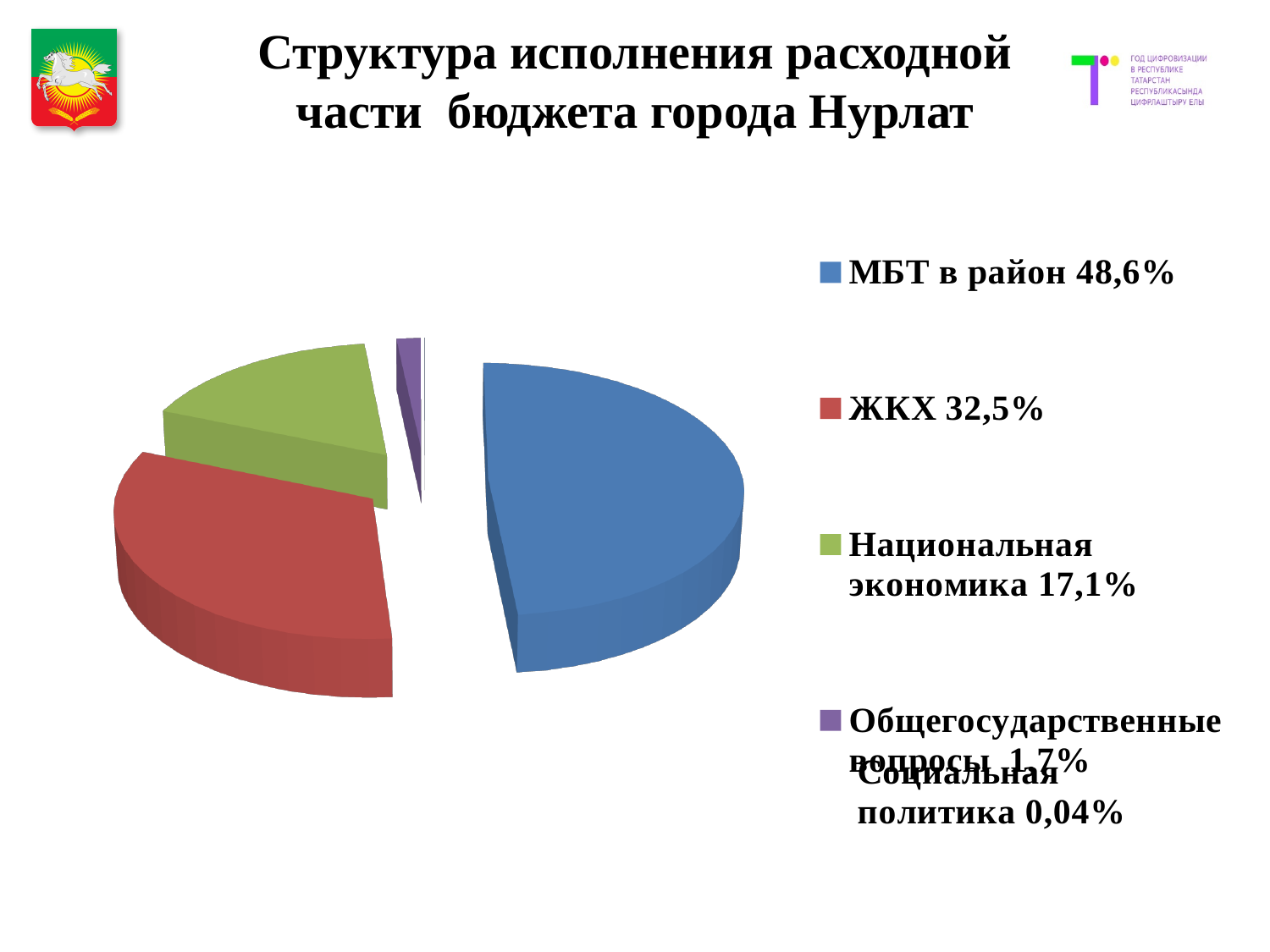
Which is larger, ЖКХ or Национальная экономика? ЖКХ How many entries with colour markers does the legend list? 4 What is the difference in percentage points between ЖКХ and Национальная экономика? 15,4% What is the title of the slide? Структура исполнения расходной части бюджета города Нурлат What share does ЖКХ have according to the legend? 32,5% What is the difference in percentage points between МБТ в район and ЖКХ? 16,1% What share does МБТ в район have according to the legend? 48,6% What colour is the ЖКХ slice? red What share does Национальная экономика have according to the legend? 17,1% What share does Общегосударственные вопросы have according to the legend? 1,7% What kind of chart is shown on the slide? pie chart Which category has the largest slice of the pie? МБТ в район